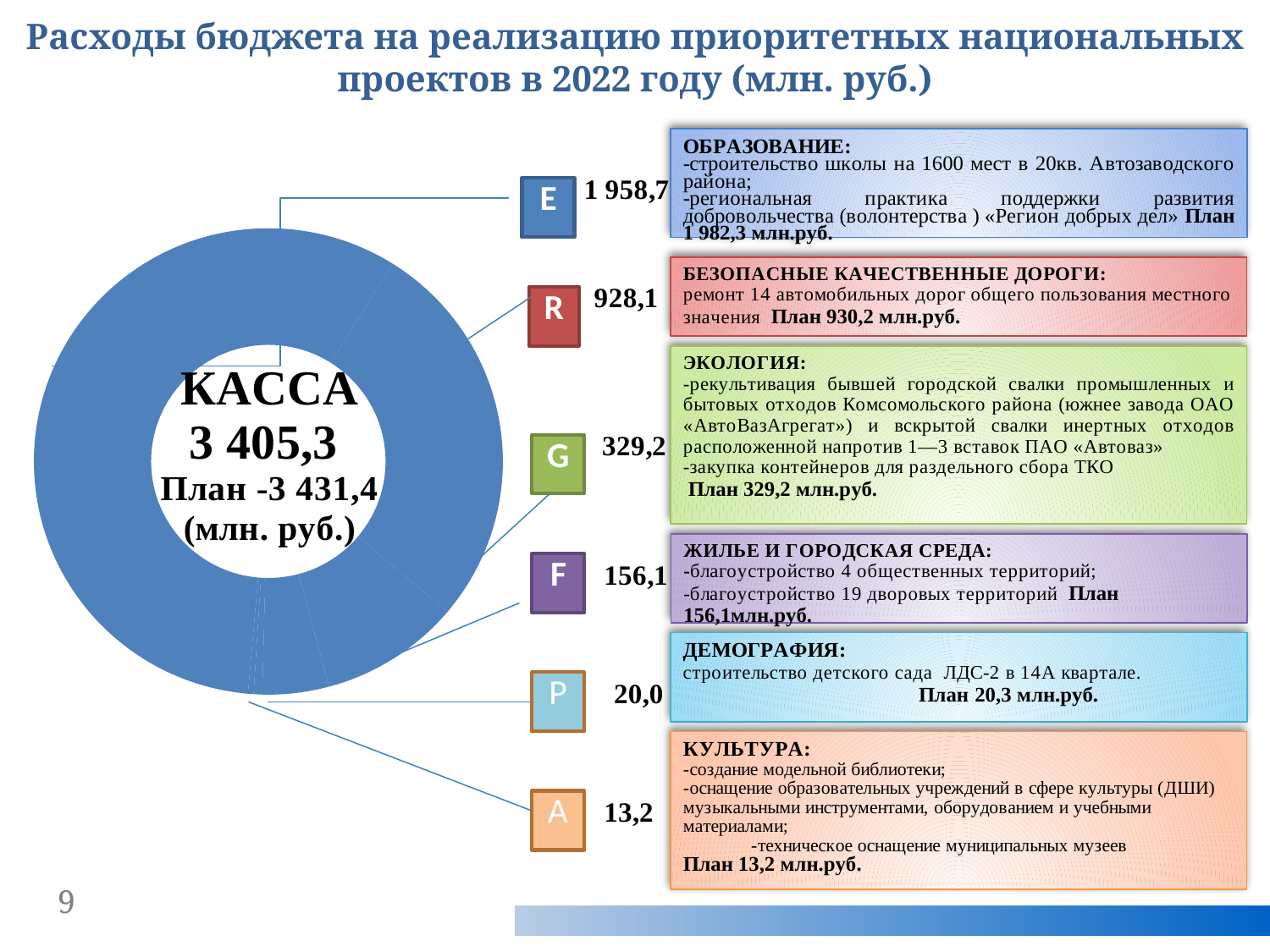
What planned total (План) is shown in the centre of the chart? 3 431,4 How many segments (national projects) does the chart show? 6 What kind of chart is shown on the slide? Pie chart (donut) What is the value shown for segment G (Экология)? 329,2 Which segment has the lowest value? A (Культура) What is the value shown for segment R (Безопасные качественные дороги)? 928,1 What total (КАССА) is shown in the centre of the chart? 3 405,3 What is the value shown for segment E (Образование)? 1 958,7 Which is larger, the value for segment F or the value for segment P? F What is the difference between the values for segment E and segment R? 1 030,6 Which segment has the highest value? E (Образование) What is the value shown for segment A (Культура)? 13,2